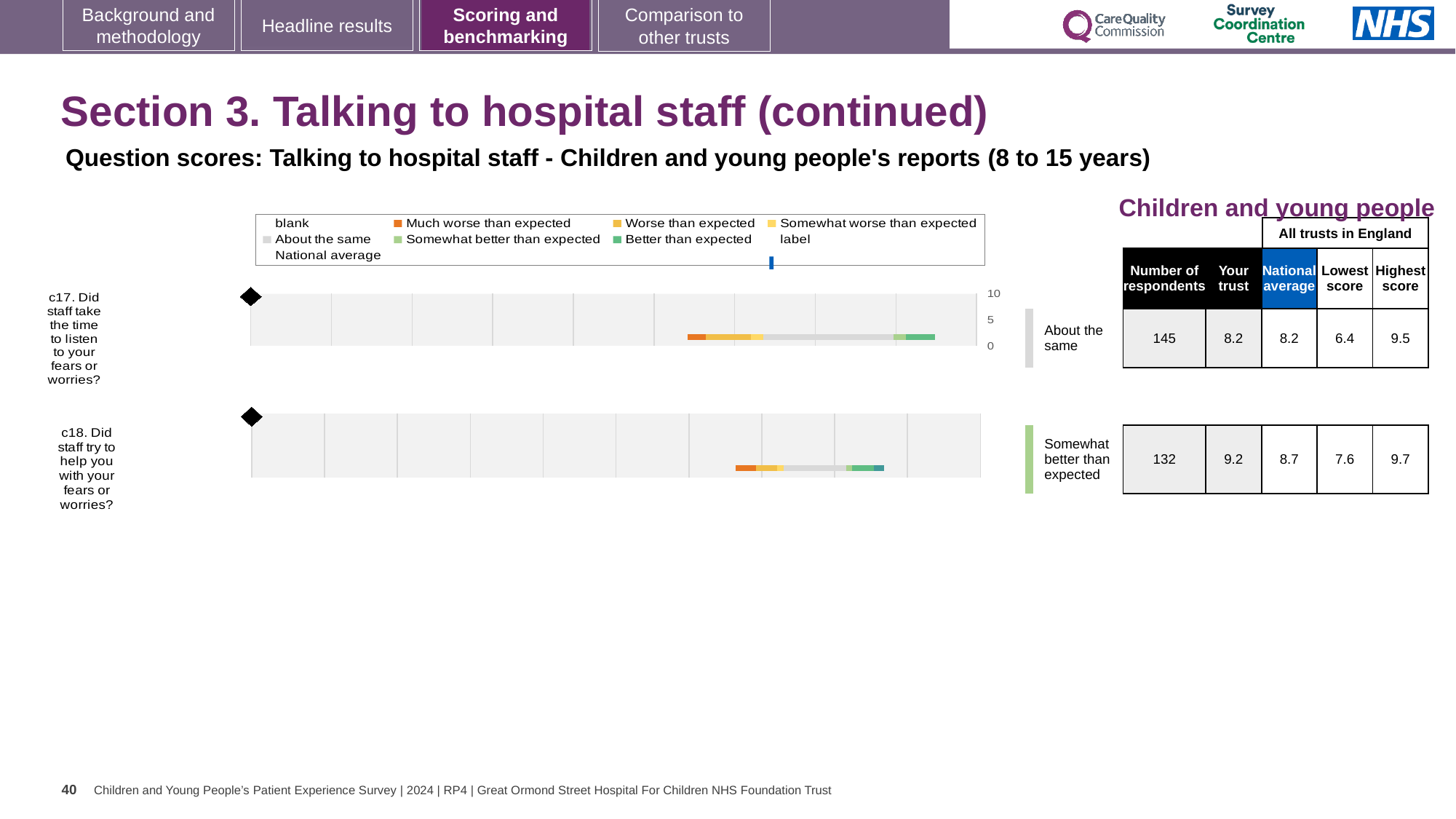
What is the national average score for c18? 8.7 What is the lowest score among all trusts in England for c17? 6.4 What kind of chart is used to show the c17 and c18 question scores? bar chart Which question has the higher 'Your trust' score, c17 or c18? c18 What is the 'Your trust' score for c17 (Did staff take the time to listen to your fears or worries?)? 8.2 What benchmark category is the trust's c18 score placed in? Somewhat better than expected How many respondents answered question c17? 145 For c18, how much higher is the trust's score than the national average? 0.5 What is the 'Your trust' score for c18 (Did staff try to help you with your fears or worries?)? 9.2 Is the trust's score for c18 greater or less than 5 on the axis? greater What is the difference between the highest and lowest scores for c17? 3.1 How many survey questions (bars) are plotted on the slide? 2